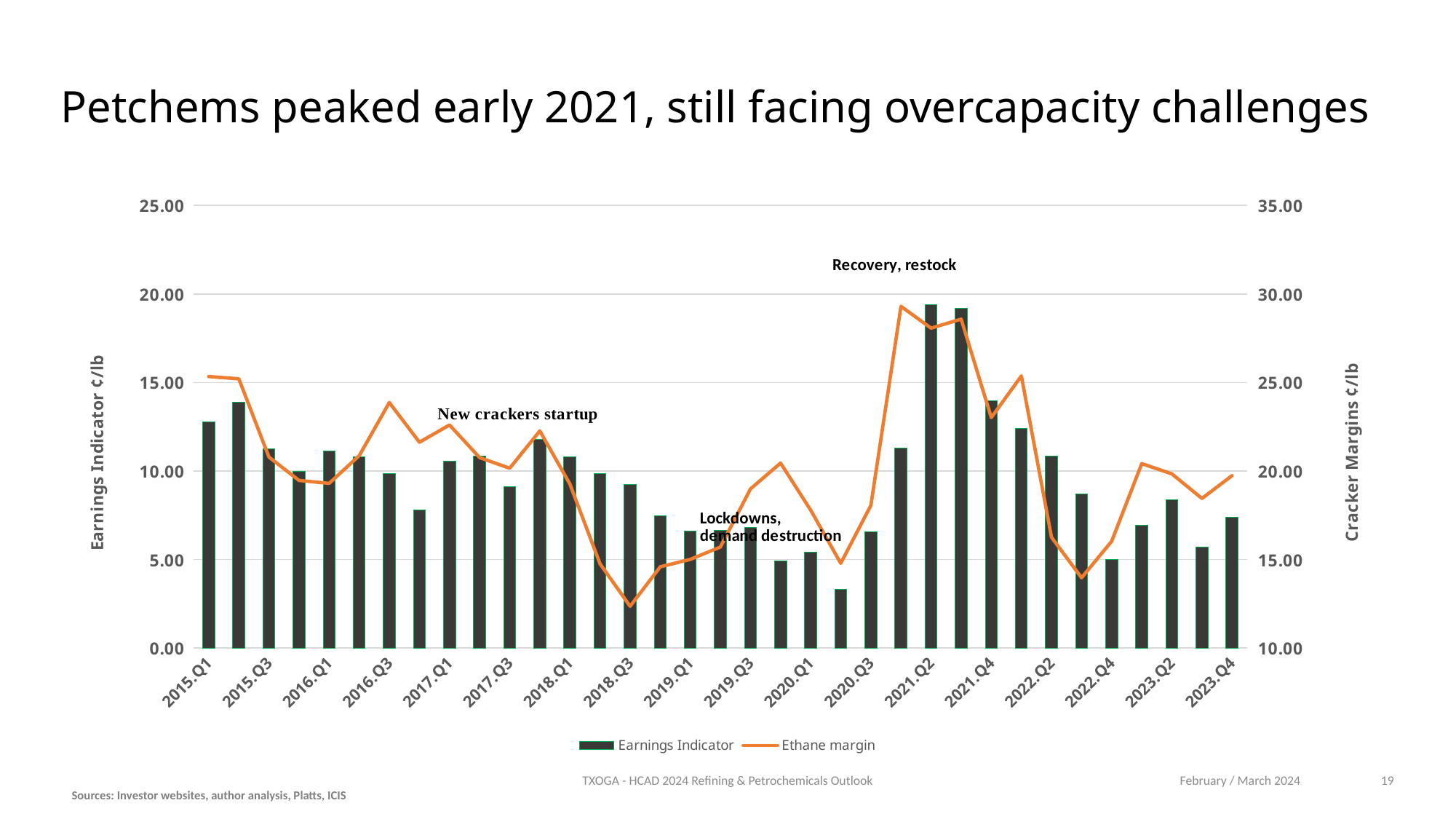
Do the Earnings Indicator bars rise or fall from 2021.Q2 to 2022.Q4? fall Is the Earnings Indicator value for 2015.Q1 greater or less than 10.00? greater Which series is drawn as an orange line? Ethane margin Which is larger, the Earnings Indicator for 2015.Q1 or for 2023.Q4? 2015.Q1 What kind of chart is shown on the slide? A combined bar and line chart Is the Earnings Indicator value for 2021.Q2 greater or less than 15.00? greater Is the Earnings Indicator value for 2020.Q2 greater or less than 5.00? less How many series does the legend list? 2 Which quarter has the lowest Earnings Indicator bar? 2020.Q2 What is the title of the right-hand vertical axis? Cracker Margins ¢/lb